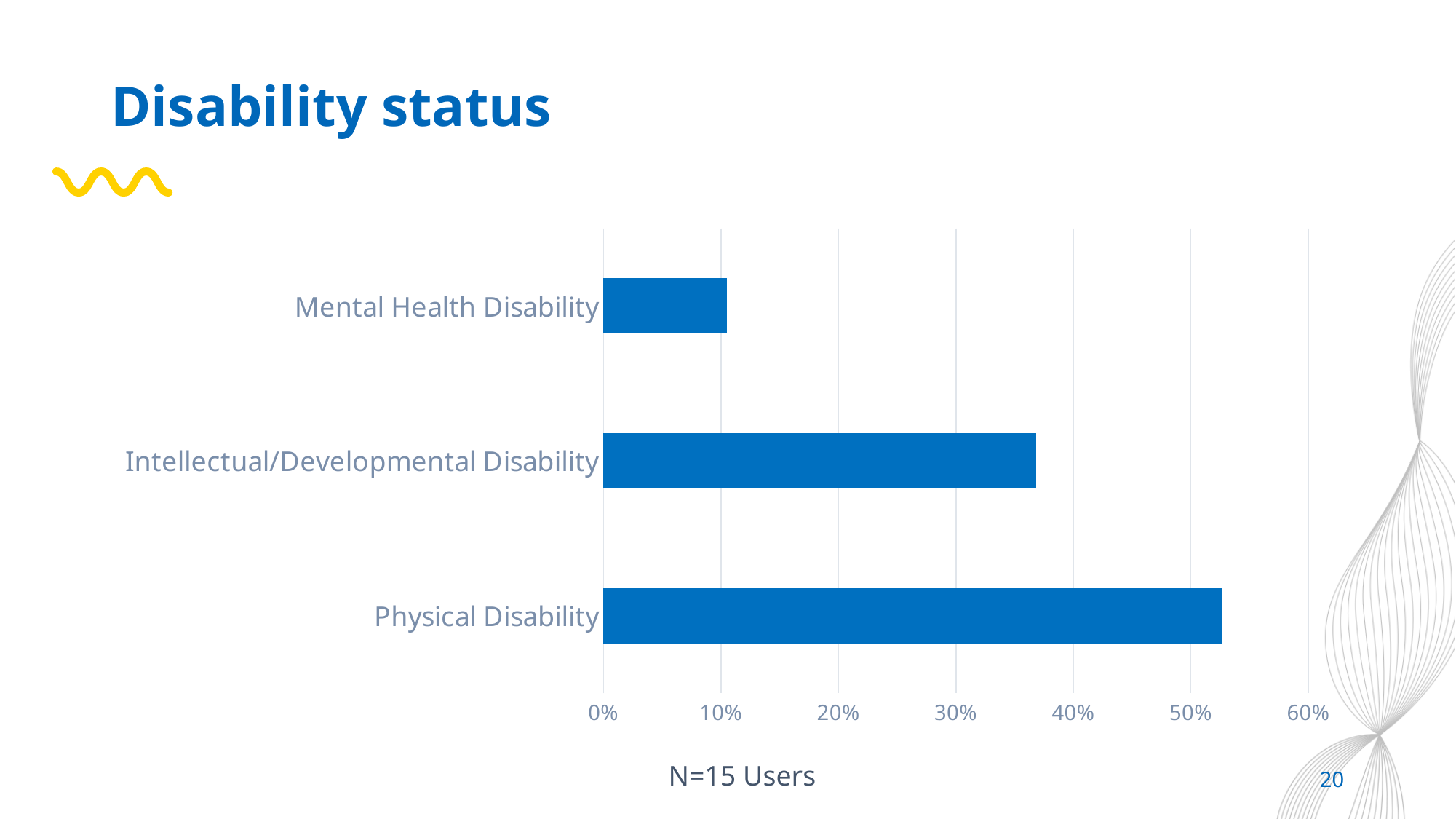
How many users does the note below the chart say the data is based on? 15 How many disability categories are shown in the chart? 3 Which disability category has the lowest value? Mental Health Disability Is the value for Physical Disability greater or less than 50%? greater Is the value for Mental Health Disability greater or less than 20%? less Which is larger, the value for Mental Health Disability or the value for Intellectual/Developmental Disability? Intellectual/Developmental Disability What is the title of the slide containing the chart? Disability status Is the value for Intellectual/Developmental Disability greater or less than 30%? greater What kind of chart is shown on the slide? bar chart Which disability category has the highest value? Physical Disability Which is larger, the value for Physical Disability or the value for Intellectual/Developmental Disability? Physical Disability